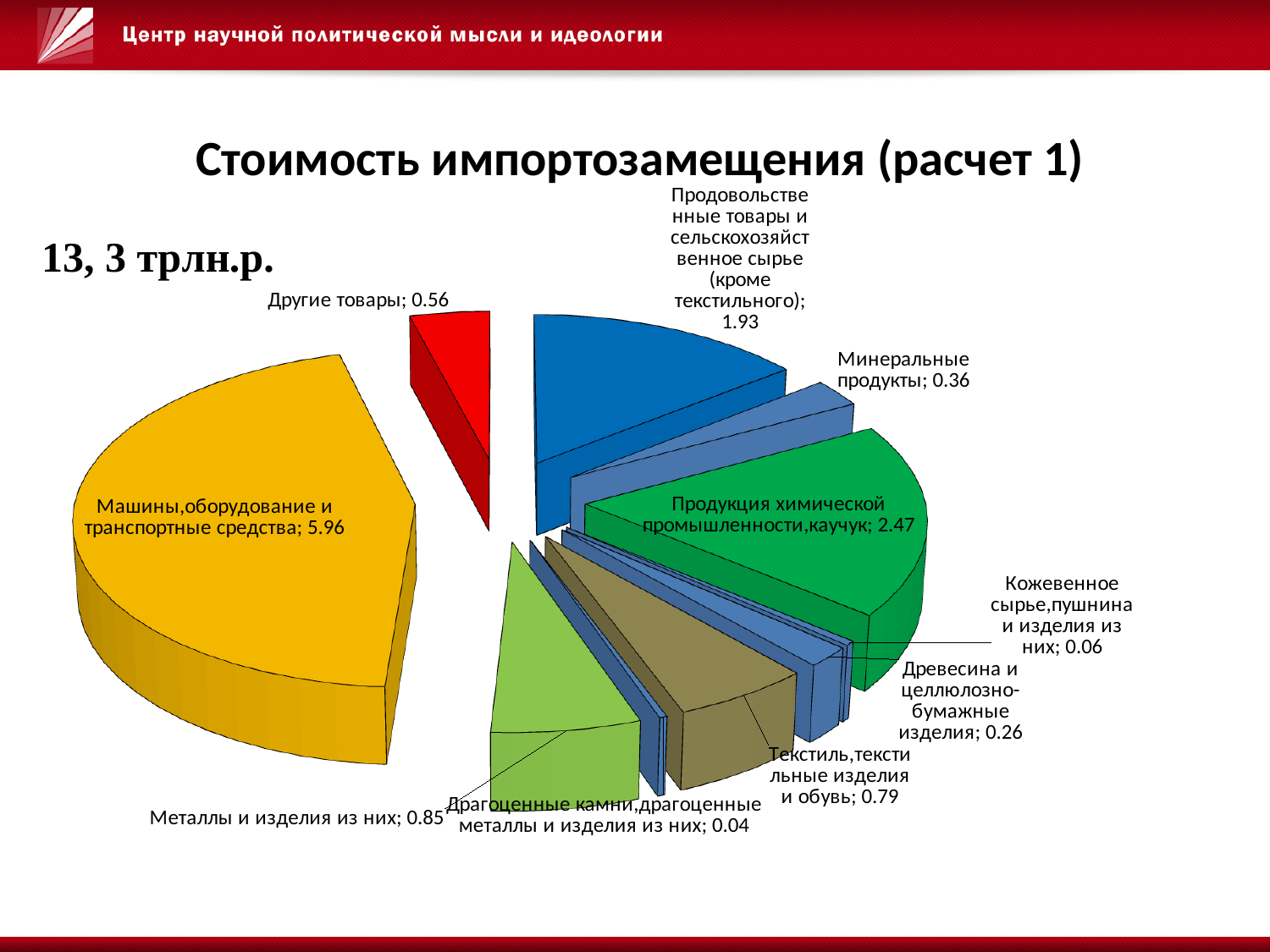
What is the difference between the values for "Машины, оборудование и транспортные средства" and "Продукция химической промышленности, каучук"? 3.49 What is the value for "Продукция химической промышленности, каучук"? 2.47 What type of chart is shown on the slide? Pie chart What is the value for "Машины, оборудование и транспортные средства"? 5.96 What total value is stated in large text to the left of the chart? 13, 3 трлн.р. Which is larger: the value for "Продовольственные товары и сельскохозяйственное сырье (кроме текстильного)" or for "Продукция химической промышленности, каучук"? Продукция химической промышленности, каучук Which category has the smallest value? Драгоценные камни, драгоценные металлы и изделия из них What is the value for "Минеральные продукты"? 0.36 Which category has the largest slice of the pie? Машины, оборудование и транспортные средства What is the value for "Текстиль, текстильные изделия и обувь"? 0.79 What is the title of the chart? Стоимость импортозамещения (расчет 1) How many categories (slices) does the pie chart have? 10